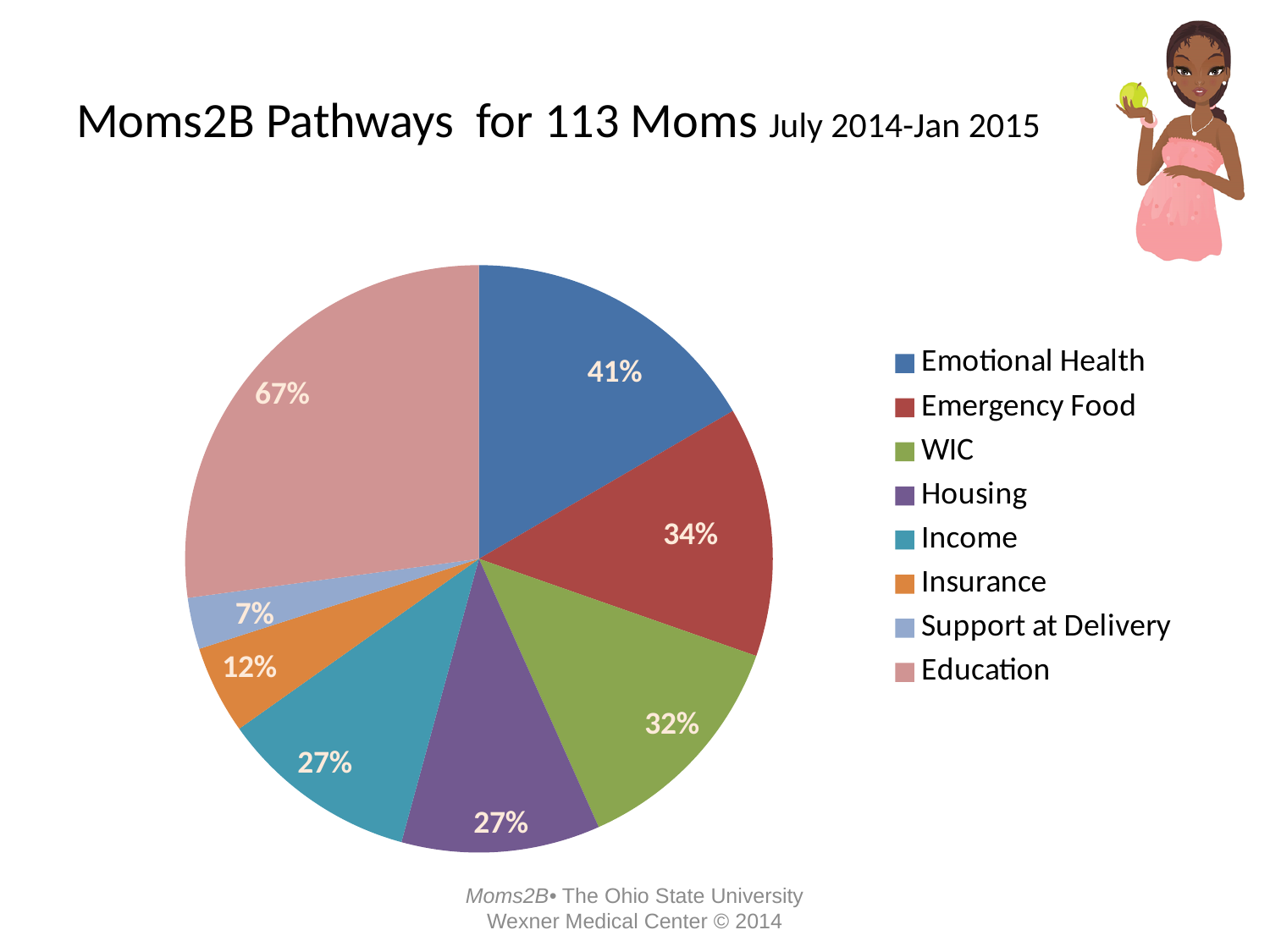
What is the value labelled for Emotional Health? 41% Which pathway has the lowest labelled value? Support at Delivery Which has the larger labelled value, Emergency Food or WIC? Emergency Food What is the difference between the labelled values for Education and Emotional Health? 26 percentage points How many moms does the chart title say the pathways are for? 113 What is the value labelled for Emergency Food? 34% Which pathway has the highest labelled value? Education What is the value labelled for Insurance? 12% What is the value labelled for Support at Delivery? 7% What kind of chart is shown on the slide? pie chart What is the value labelled for Education? 67% How many pathways (slices) does the pie chart show? 8